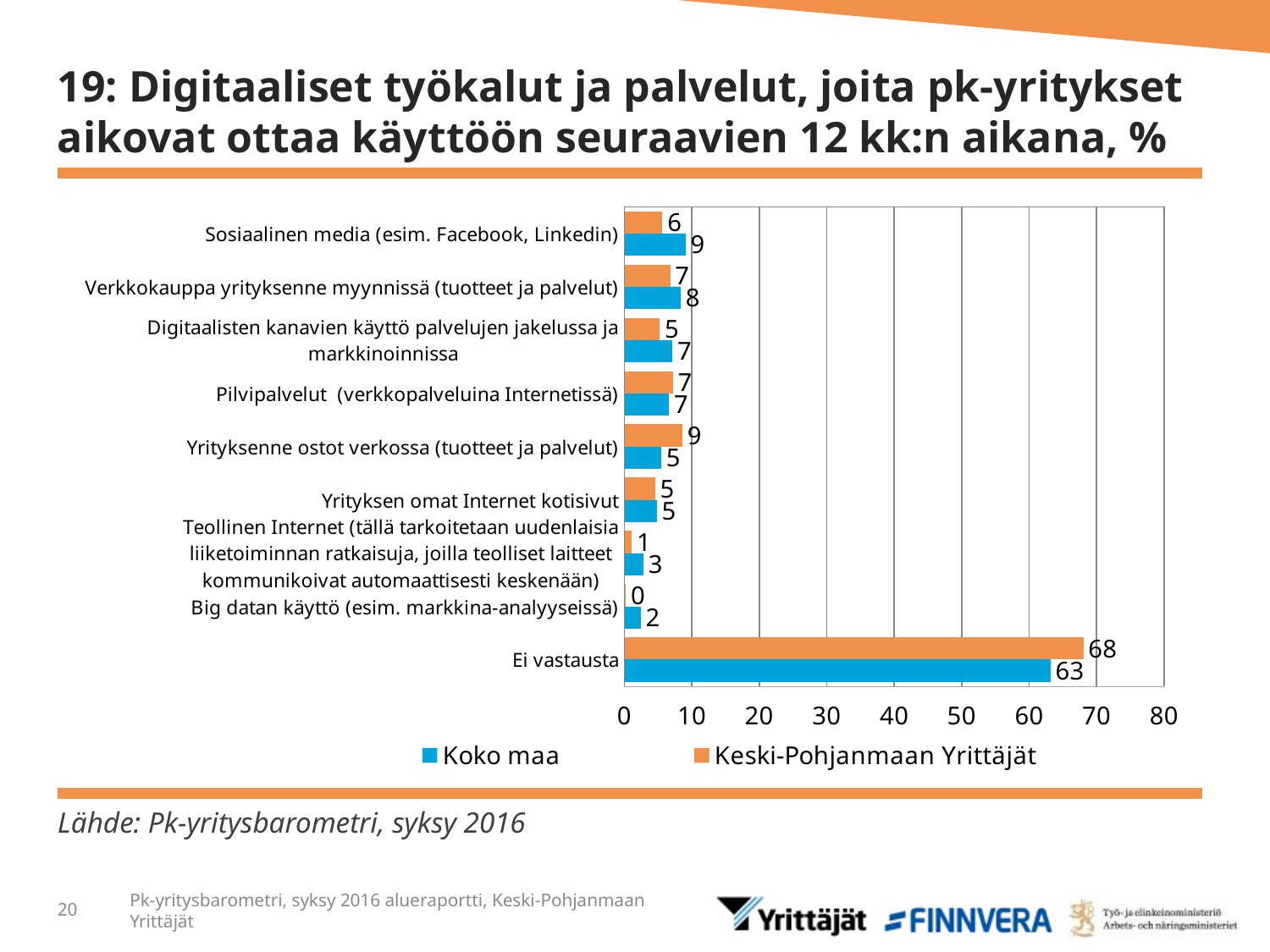
What is the Koko maa value for Sosiaalinen media (esim. Facebook, Linkedin)? 9 Which category has the highest Keski-Pohjanmaan Yrittäjät value? Ei vastausta Which colour represents the Keski-Pohjanmaan Yrittäjät series? Orange How many series does the legend list? 2 For Sosiaalinen media (esim. Facebook, Linkedin), which series has the larger value, Koko maa or Keski-Pohjanmaan Yrittäjät? Koko maa What is the Koko maa value for Ei vastausta? 63 What kind of chart is shown on the slide? Bar chart Which category has the lowest Koko maa value? Big datan käyttö (esim. markkina-analyyseissä) What is the difference between the Keski-Pohjanmaan Yrittäjät and Koko maa values for Ei vastausta? 5 What is the Keski-Pohjanmaan Yrittäjät value for Big datan käyttö (esim. markkina-analyyseissä)? 0 What is the Keski-Pohjanmaan Yrittäjät value for Yrityksenne ostot verkossa (tuotteet ja palvelut)? 9 How many categories are shown on the chart? 9